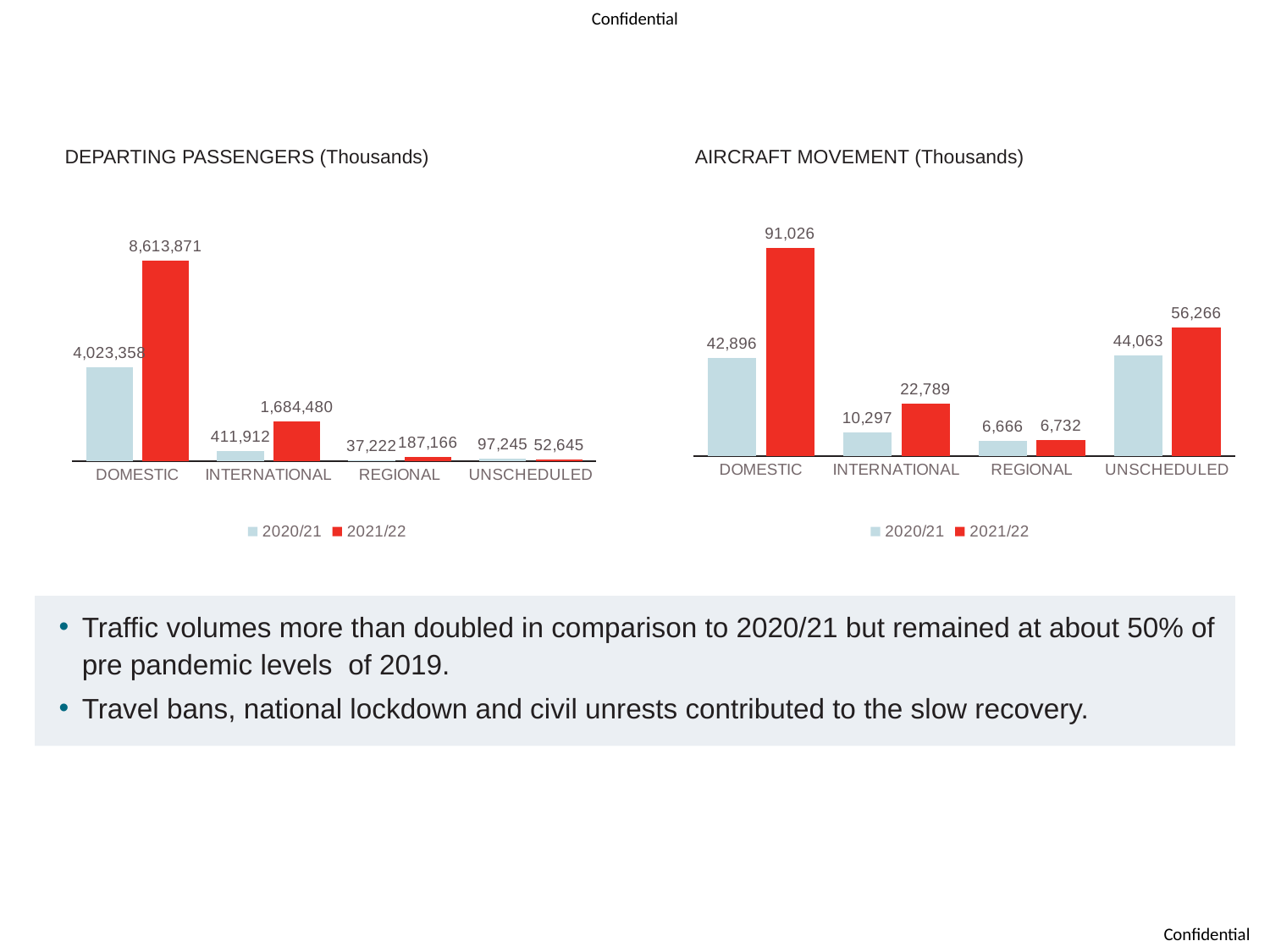
In the DEPARTING PASSENGERS chart, which category has the lowest 2020/21 value? REGIONAL In the DEPARTING PASSENGERS chart, what is the 2021/22 value for DOMESTIC? 8,613,871 In the DEPARTING PASSENGERS chart, which is larger for UNSCHEDULED: the 2020/21 value or the 2021/22 value? 2020/21 What type of chart is the AIRCRAFT MOVEMENT chart? Bar chart In the AIRCRAFT MOVEMENT chart, what is the 2020/21 value for REGIONAL? 6,666 In the AIRCRAFT MOVEMENT chart, what is the 2021/22 value for UNSCHEDULED? 56,266 How many categories are shown on the x axis of the AIRCRAFT MOVEMENT chart? 4 In the DEPARTING PASSENGERS chart, what is the difference between the 2021/22 and 2020/21 values for DOMESTIC? 4,590,513 In the AIRCRAFT MOVEMENT chart, which category has the highest 2021/22 value? DOMESTIC In the AIRCRAFT MOVEMENT chart, what is the difference between the 2021/22 and 2020/21 values for INTERNATIONAL? 12,492 In the DEPARTING PASSENGERS chart, what is the 2020/21 value for INTERNATIONAL? 411,912 How many series does the legend of the DEPARTING PASSENGERS chart list? 2